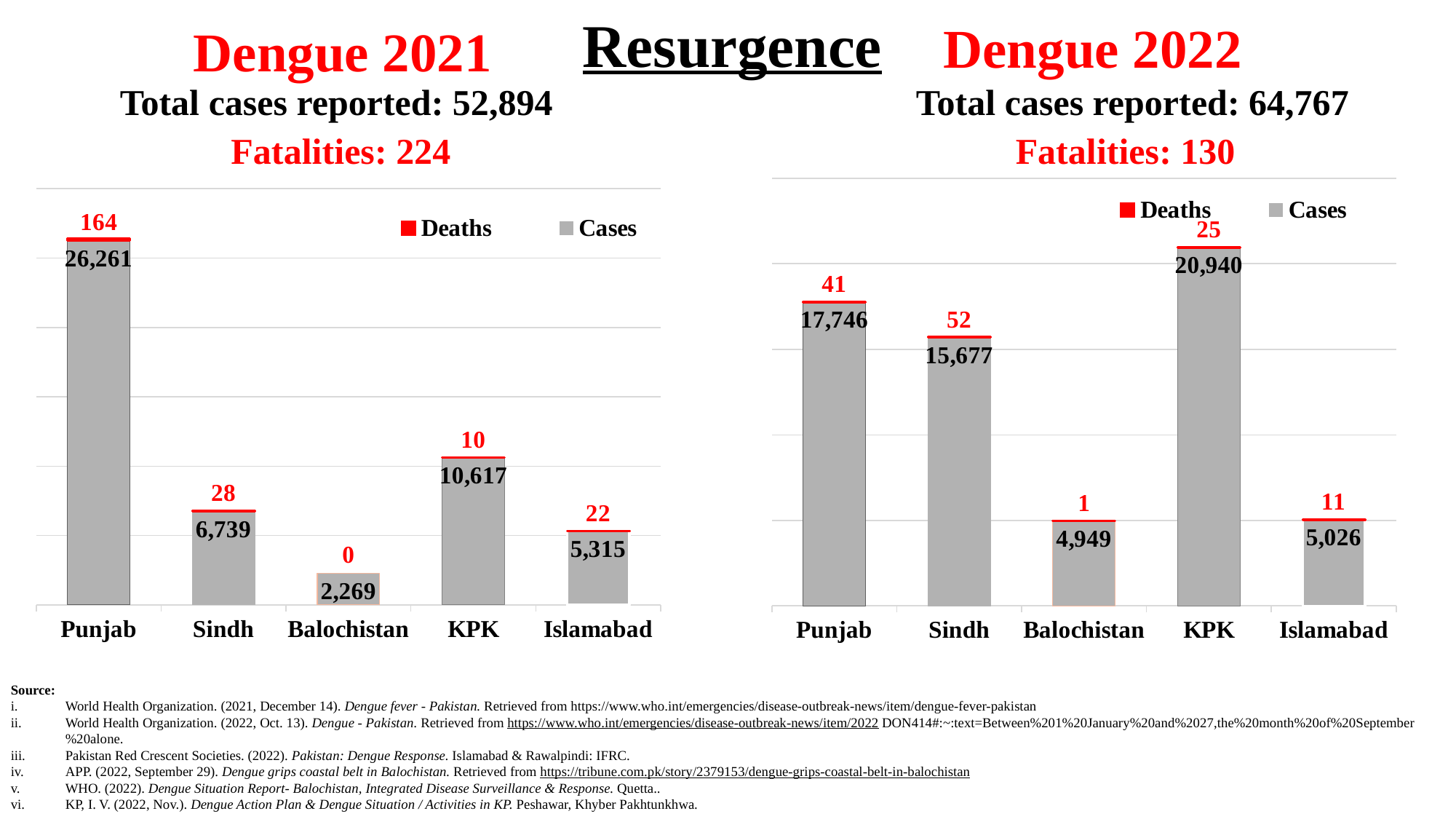
In the Dengue 2022 chart, how many cases are shown for KPK? 20,940 In the Dengue 2022 chart, which province has the highest number of cases? KPK In the Dengue 2022 chart, which has more cases, Punjab or Sindh? Punjab In the Dengue 2022 chart, how many deaths are shown for Balochistan? 1 In the Dengue 2022 chart, which province has the highest number of deaths? Sindh How many provinces/regions are shown on the x axis of the Dengue 2021 chart? 5 In the Dengue 2021 chart, how many deaths are shown for Sindh? 28 In the Dengue 2021 chart, what is the difference in cases between Punjab and KPK? 15,644 How many series does the legend of the Dengue 2022 chart list? 2 In the Dengue 2021 chart, how many cases are shown for Punjab? 26,261 In the Dengue 2021 chart, which province has the lowest number of cases? Balochistan What type of chart is the Dengue 2021 chart? Bar chart